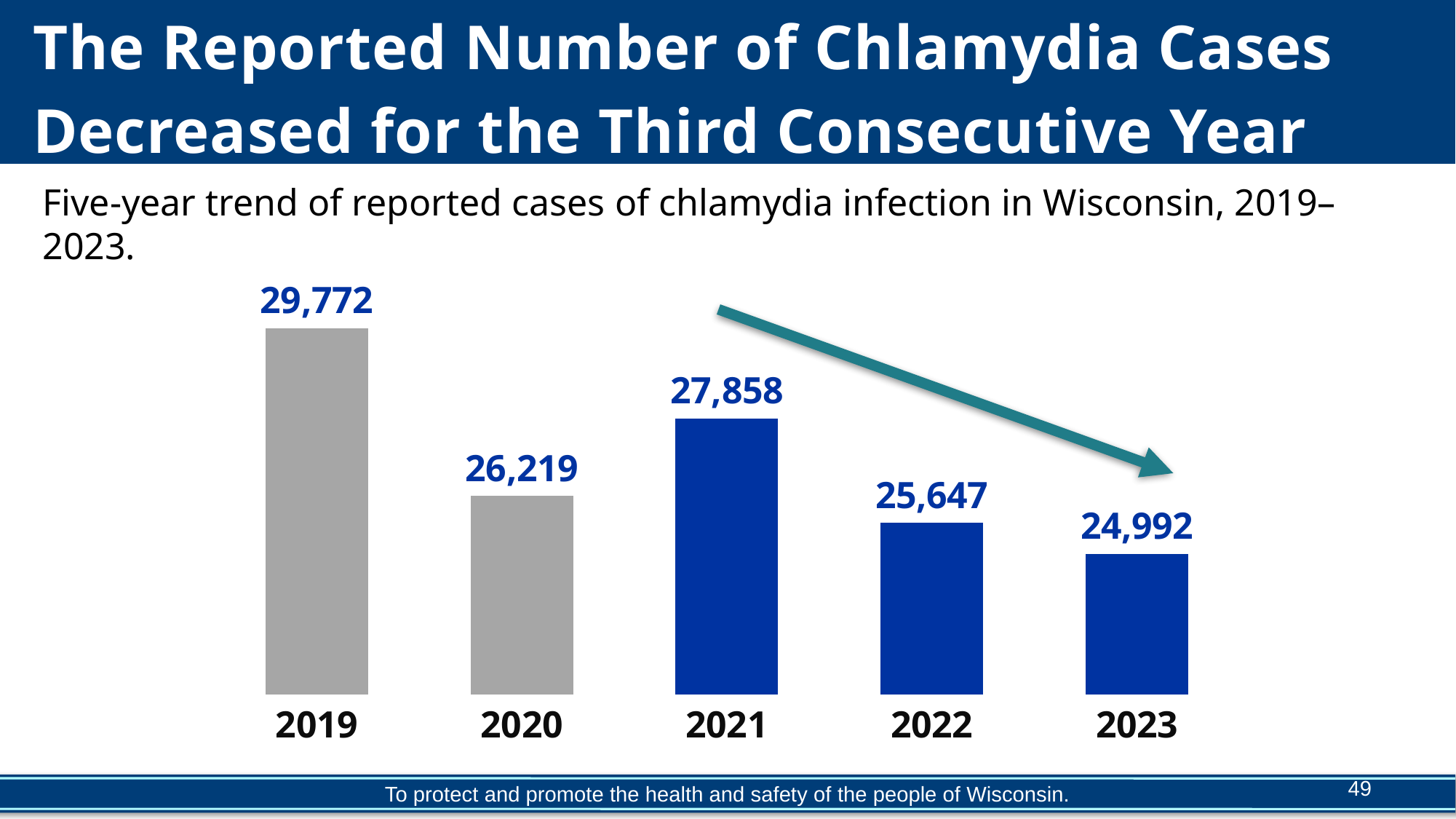
What was the reported number of chlamydia cases in 2023? 24,992 Which year had the highest number of reported chlamydia cases? 2019 What is the difference between the number of cases in 2022 and 2023? 655 Which years' bars are coloured grey rather than blue? 2019 and 2020 What is the difference between the number of cases in 2019 and 2020? 3,553 Did the number of reported cases rise or fall from 2021 to 2023? Fall Which year had the lowest number of reported chlamydia cases? 2023 What was the reported number of chlamydia cases in 2019? 29,772 What was the reported number of chlamydia cases in 2021? 27,858 How many years are shown in the chart? 5 What kind of chart is shown on the slide? Bar chart Which year had more reported cases, 2020 or 2021? 2021